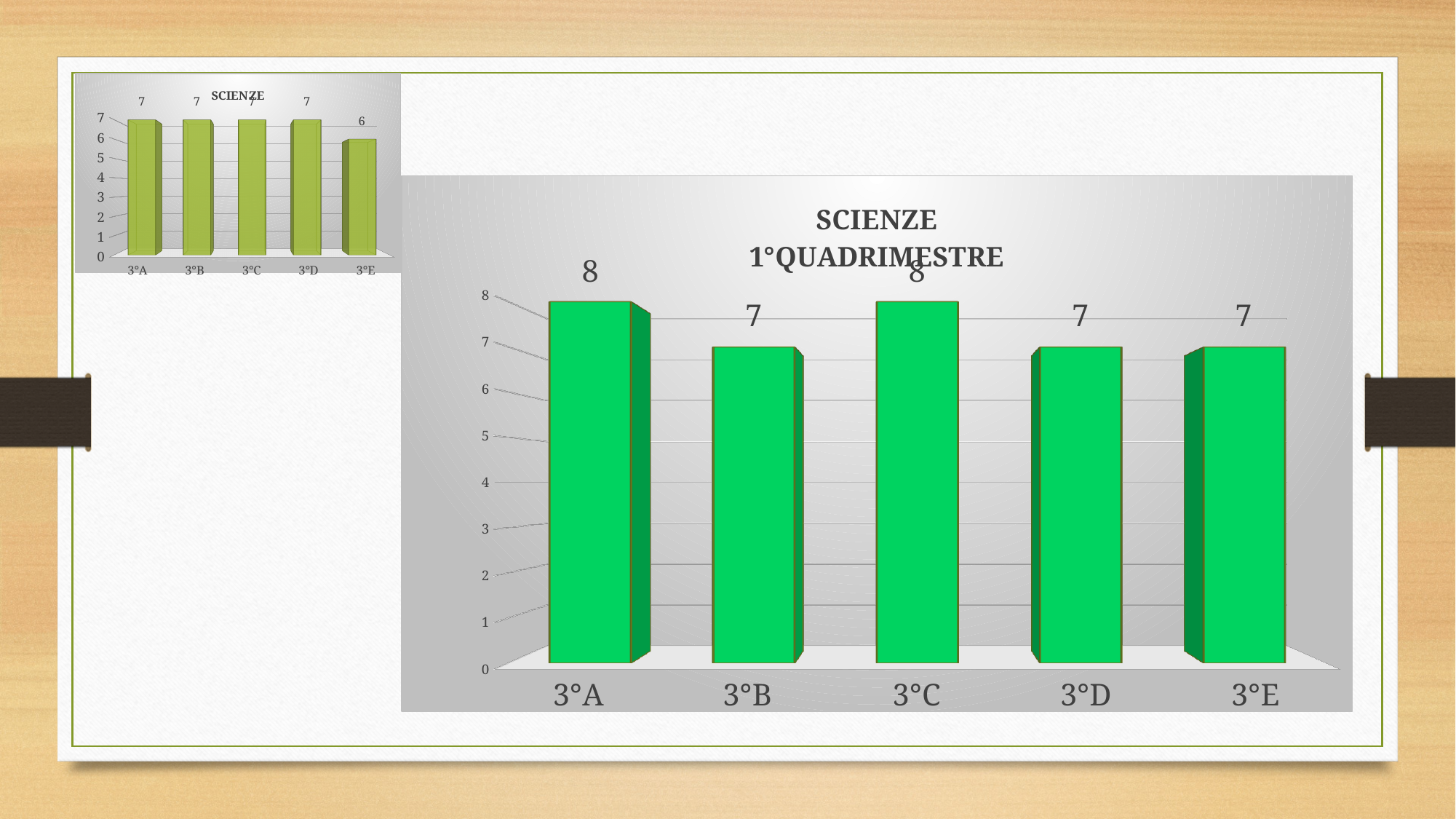
In the SCIENZE 1°QUADRIMESTRE chart, what is the difference between the values for 3°A and 3°B? 1 In the SCIENZE 1°QUADRIMESTRE chart, what is the value for 3°B? 7 In the small SCIENZE chart at the top left, what is the difference between the values for 3°D and 3°E? 1 In the SCIENZE 1°QUADRIMESTRE chart, what is the value for 3°E? 7 How many categories are shown in the SCIENZE 1°QUADRIMESTRE chart? 5 In the SCIENZE 1°QUADRIMESTRE chart, which is larger, the value for 3°C or the value for 3°D? 3°C In the small SCIENZE chart at the top left, which category has the lowest value? 3°E What kind of chart is the SCIENZE 1°QUADRIMESTRE chart? bar chart In the small SCIENZE chart at the top left, what is the value for 3°E? 6 In the small SCIENZE chart at the top left, what is the value for 3°A? 7 What is the title of the large chart on the slide? SCIENZE 1°QUADRIMESTRE In the SCIENZE 1°QUADRIMESTRE chart, what is the value for 3°A? 8